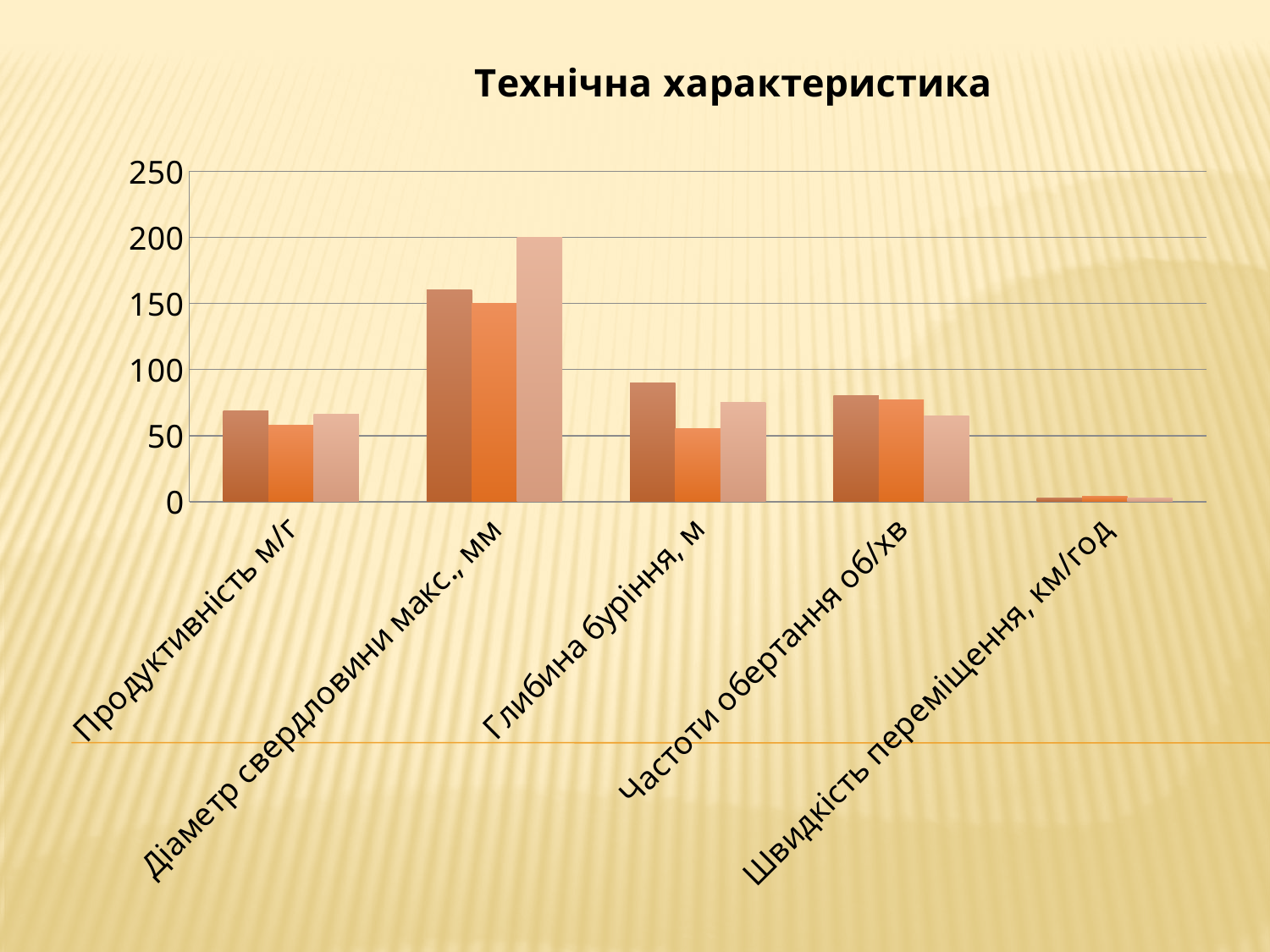
Is the value of the third (lightest) bar for Продуктивність м/г greater or less than 50? greater Are the bars for Швидкість переміщення, км/год greater or less than 50? less Is the value of the first (dark brown) bar for Діаметр свердловини макс., мм greater or less than 150? greater What kind of chart is shown on the slide? bar chart What is the title of the chart? Технічна характеристика Which category has the tallest bars in the chart? Діаметр свердловини макс., мм For Діаметр свердловини макс., мм, which is larger: the first (dark brown) bar or the third (lightest) bar? the third (lightest) bar How many categories are shown on the x axis of the chart? 5 What is the value of the third (lightest) bar for Діаметр свердловини макс., мм? 200 Which category has the lowest bars in the chart? Швидкість переміщення, км/год For Глибина буріння, м, which is larger: the first (dark brown) bar or the second (orange) bar? the first (dark brown) bar